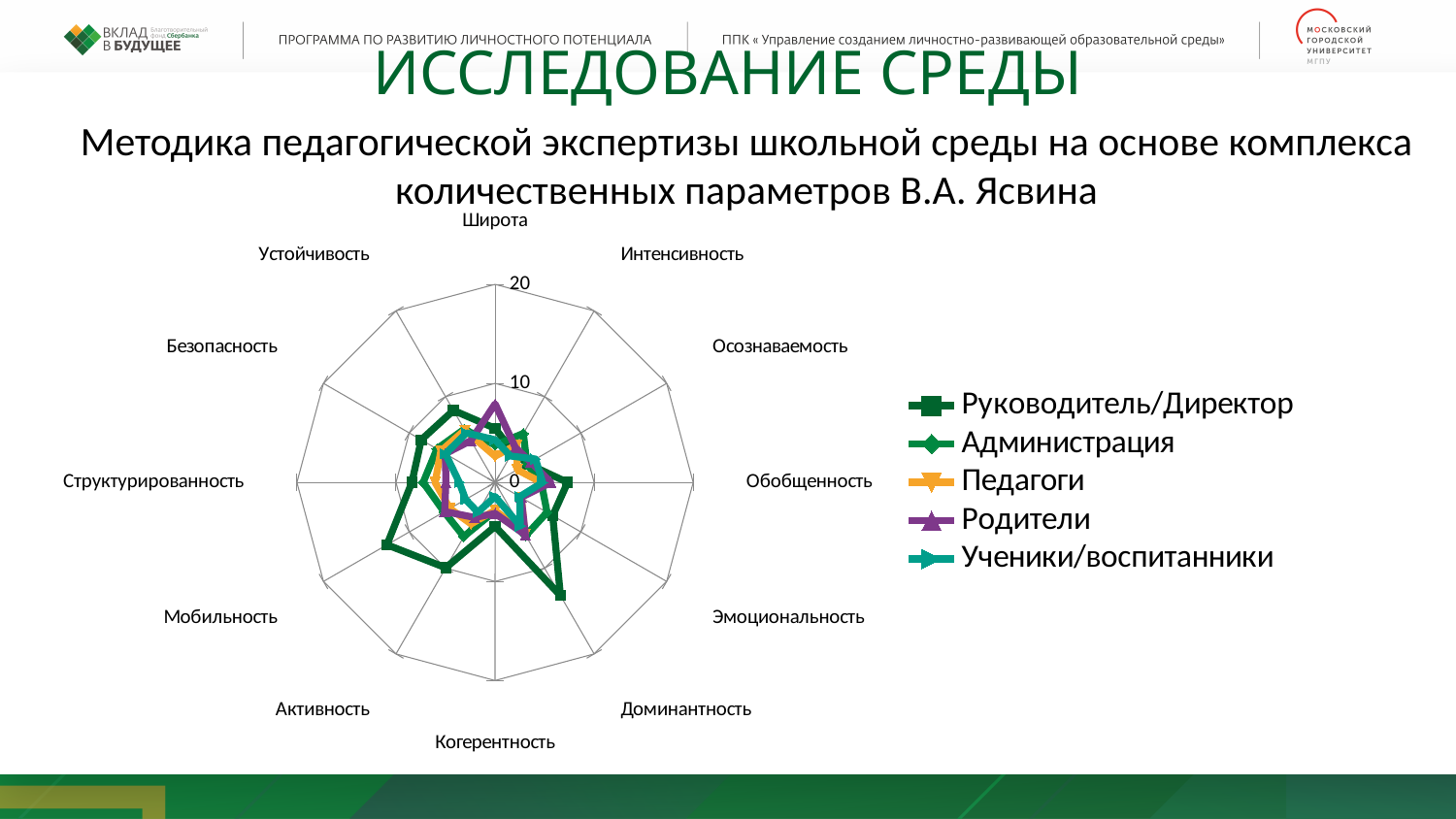
Which series has the highest value on the Мобильность axis? Руководитель/Директор Is the value for Руководитель/Директор on the Мобильность axis greater or less than 10? greater Is the value for Педагоги on the Обобщенность axis greater or less than 10? less How many category axes does the radar chart have? 12 Is the value for Руководитель/Директор on the Доминантность axis greater or less than 10? greater What is the highest value shown on the radial axis of the chart? 20 On the Доминантность axis, which is larger: the value for Руководитель/Директор or the value for Педагоги? Руководитель/Директор Which series has the highest value on the Доминантность axis? Руководитель/Директор What kind of chart is shown on the slide? Radar chart Which series is listed first in the legend? Руководитель/Директор How many series does the legend list? 5